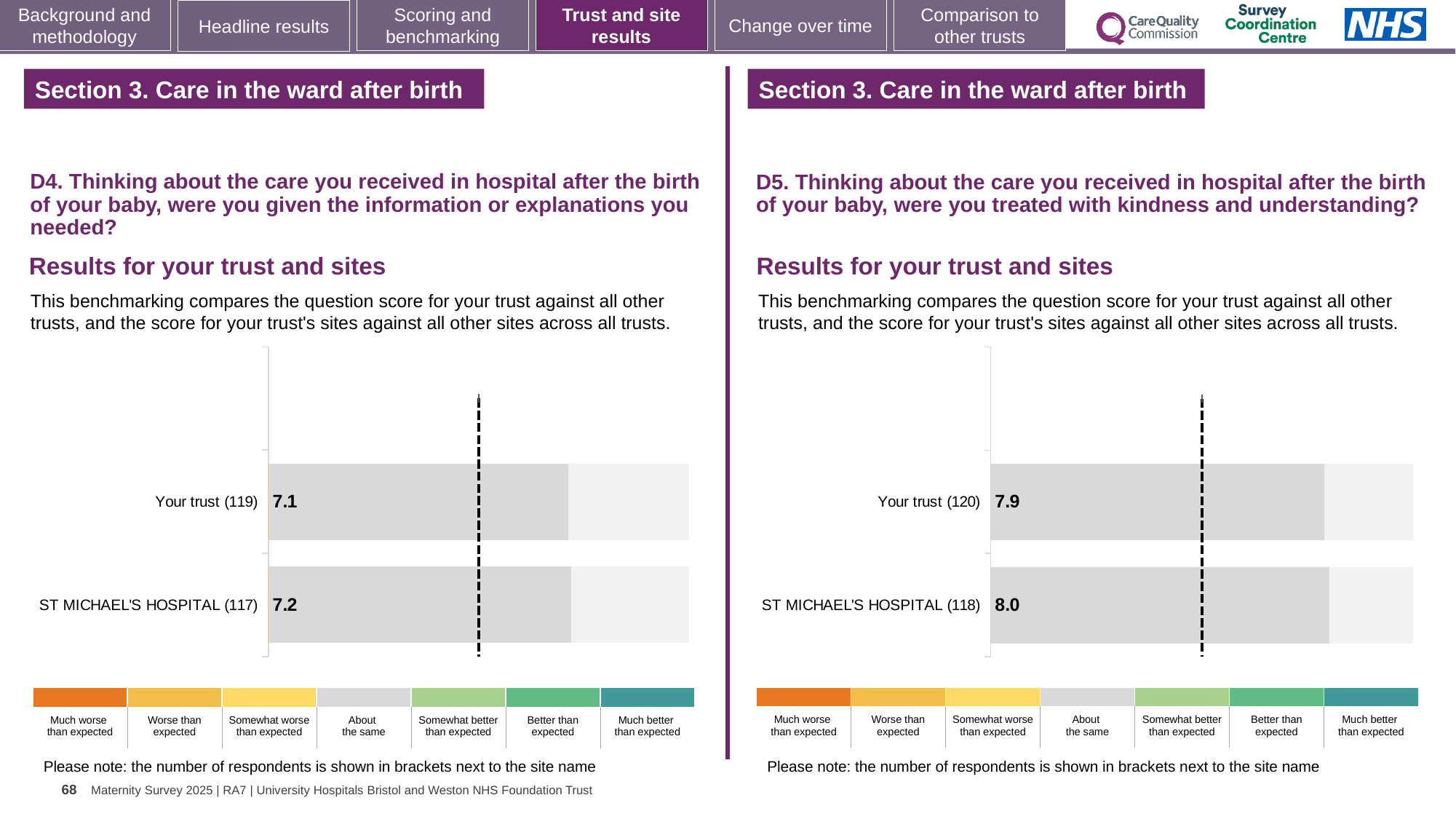
In the D5 chart on the right, how many respondents are shown in brackets for ST MICHAEL'S HOSPITAL? 118 In the D4 chart on the left, how many respondents are shown in brackets for Your trust? 119 What type of chart is used in the D5 chart on the right? Bar chart How many categories (bars) are shown in the D4 chart on the left? 2 In the D4 chart on the left, is the score for Your trust or for ST MICHAEL'S HOSPITAL larger? ST MICHAEL'S HOSPITAL In the D4 chart on the left, which category has the higher score? ST MICHAEL'S HOSPITAL In the D4 chart on the left, what is the score for Your trust? 7.1 In the D5 chart on the right, what is the score for ST MICHAEL'S HOSPITAL? 8.0 In the D4 chart on the left, what is the score for ST MICHAEL'S HOSPITAL? 7.2 In the D5 chart on the right, what is the difference between the ST MICHAEL'S HOSPITAL score and the Your trust score? 0.1 In the D5 chart on the right, which category has the lower score? Your trust In the D5 chart on the right, what is the score for Your trust? 7.9